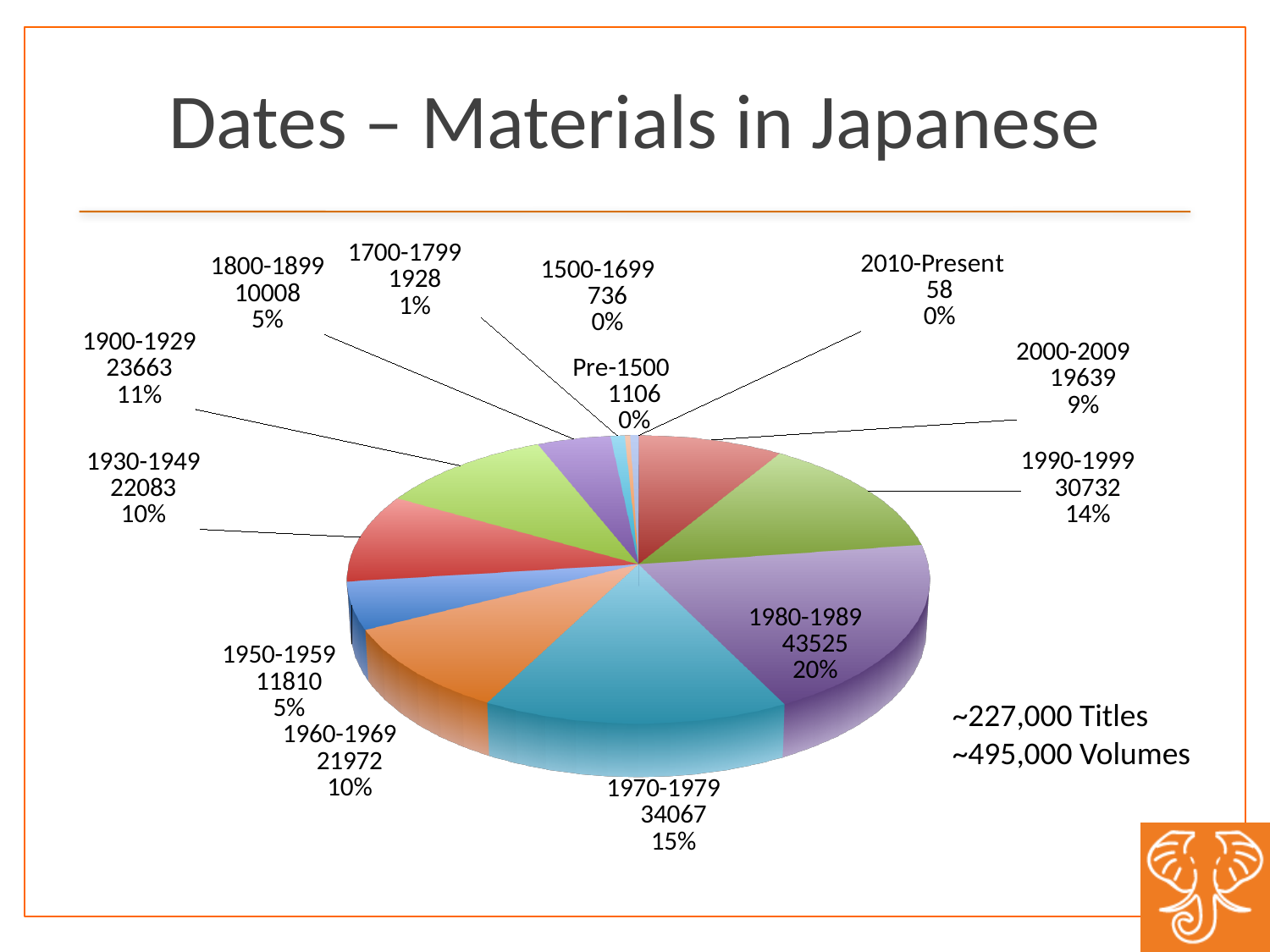
What share of the pie does 1990-1999 represent? 14% What share of the pie does 1970-1979 represent? 15% Which date range has the largest slice of the pie? 1980-1989 What is the value for 2010-Present? 58 What is the title of the slide containing the chart? Dates – Materials in Japanese How many categories (date ranges) does the pie chart show? 13 What is the value for 1980-1989? 43525 What is the difference between the values for 1980-1989 and 1970-1979? 9458 What kind of chart is shown on the slide? Pie chart What is the value for 1900-1929? 23663 Which date range has the smallest value? 2010-Present Which is larger, the value for 1930-1949 or the value for 1960-1969? 1930-1949